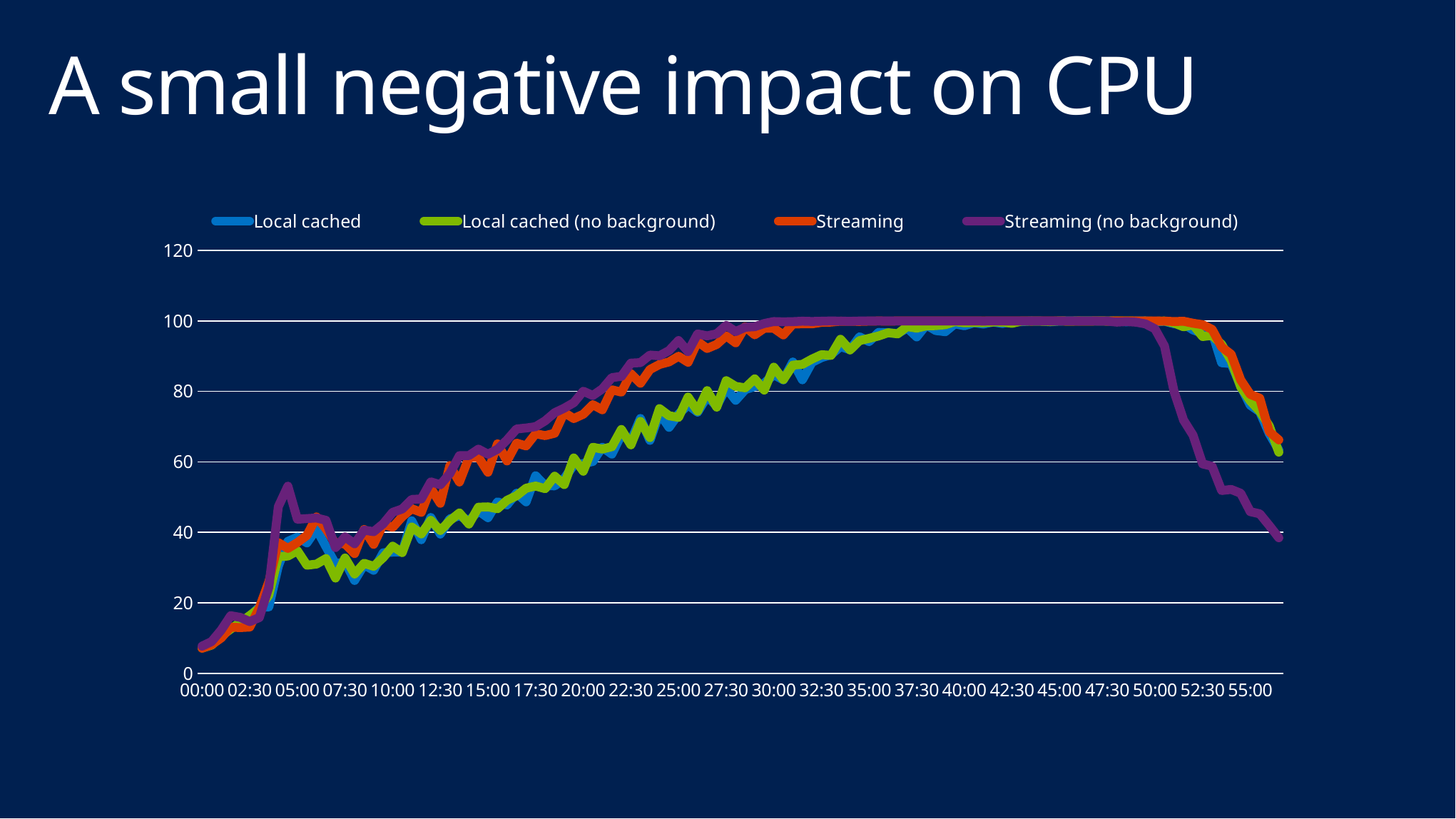
Is the value for Streaming (no background) at 55:00 greater or less than 60? less Does the Local cached series rise or fall between 10:00 and 30:00? rise At 20:00, which is larger: Streaming or Local cached? Streaming Is the value for Streaming (no background) at 05:00 greater or less than 40? greater Is the value for Local cached at 40:00 greater or less than 80? greater How many time labels are shown on the x axis? 23 Which series is drawn in purple? Streaming (no background) How many series does the legend list? 4 What kind of chart is shown on the slide? line chart What is the title of the slide containing the chart? A small negative impact on CPU